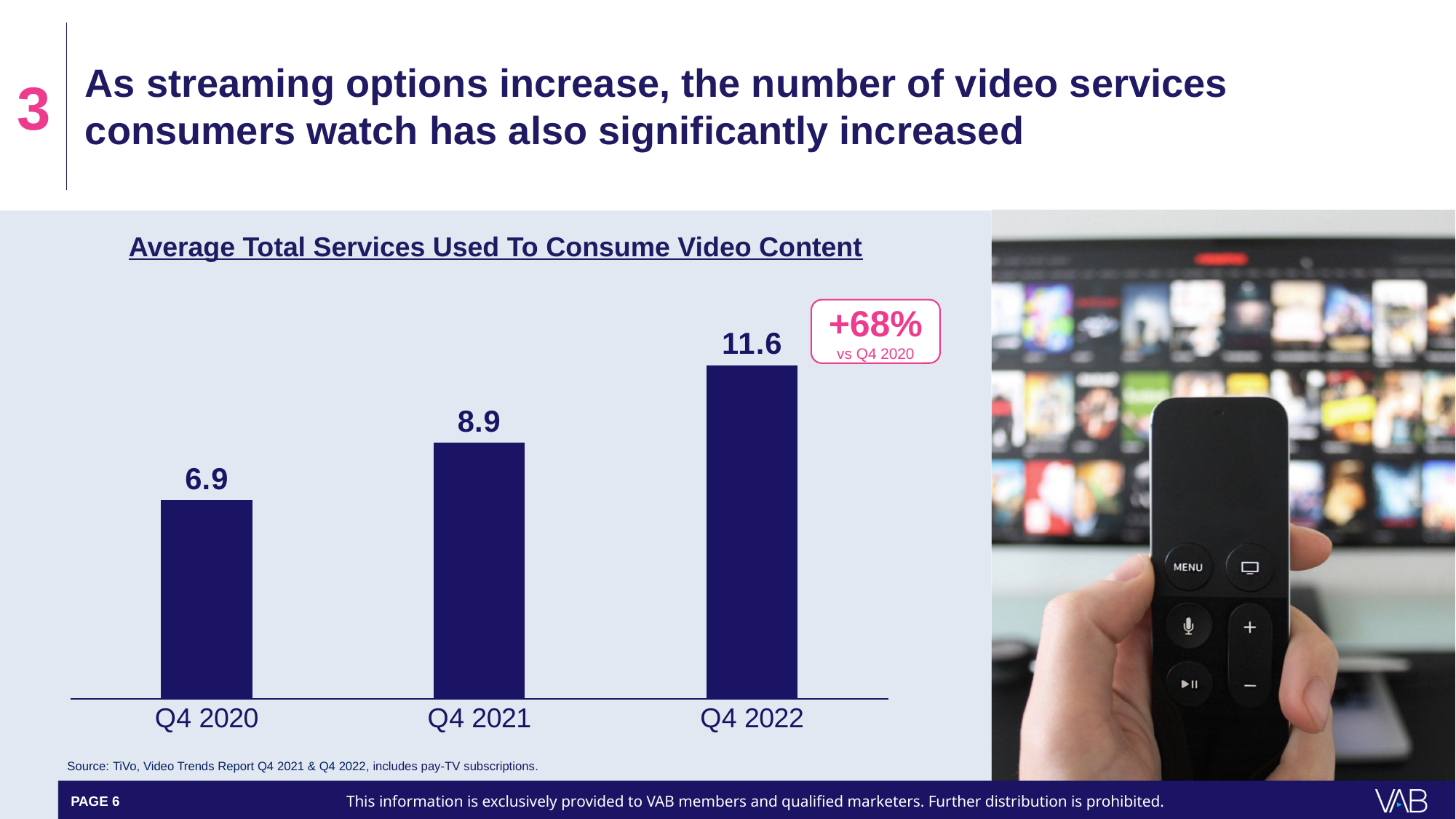
Which quarter has the highest average total services used? Q4 2022 How many quarters are plotted in the chart? 3 What kind of chart is shown on the slide? Bar chart What is the value shown for Q4 2022? 11.6 Which is larger, the value for Q4 2021 or Q4 2022? Q4 2022 What is the title of the chart? Average Total Services Used To Consume Video Content Which quarter has the lowest average total services used? Q4 2020 What is the difference between the Q4 2022 and Q4 2020 values? 4.7 What is the average total services used to consume video content in Q4 2020? 6.9 Do the values rise or fall from Q4 2020 to Q4 2022? Rise What is the difference between the Q4 2021 and Q4 2020 values? 2.0 What is the value shown for Q4 2021? 8.9